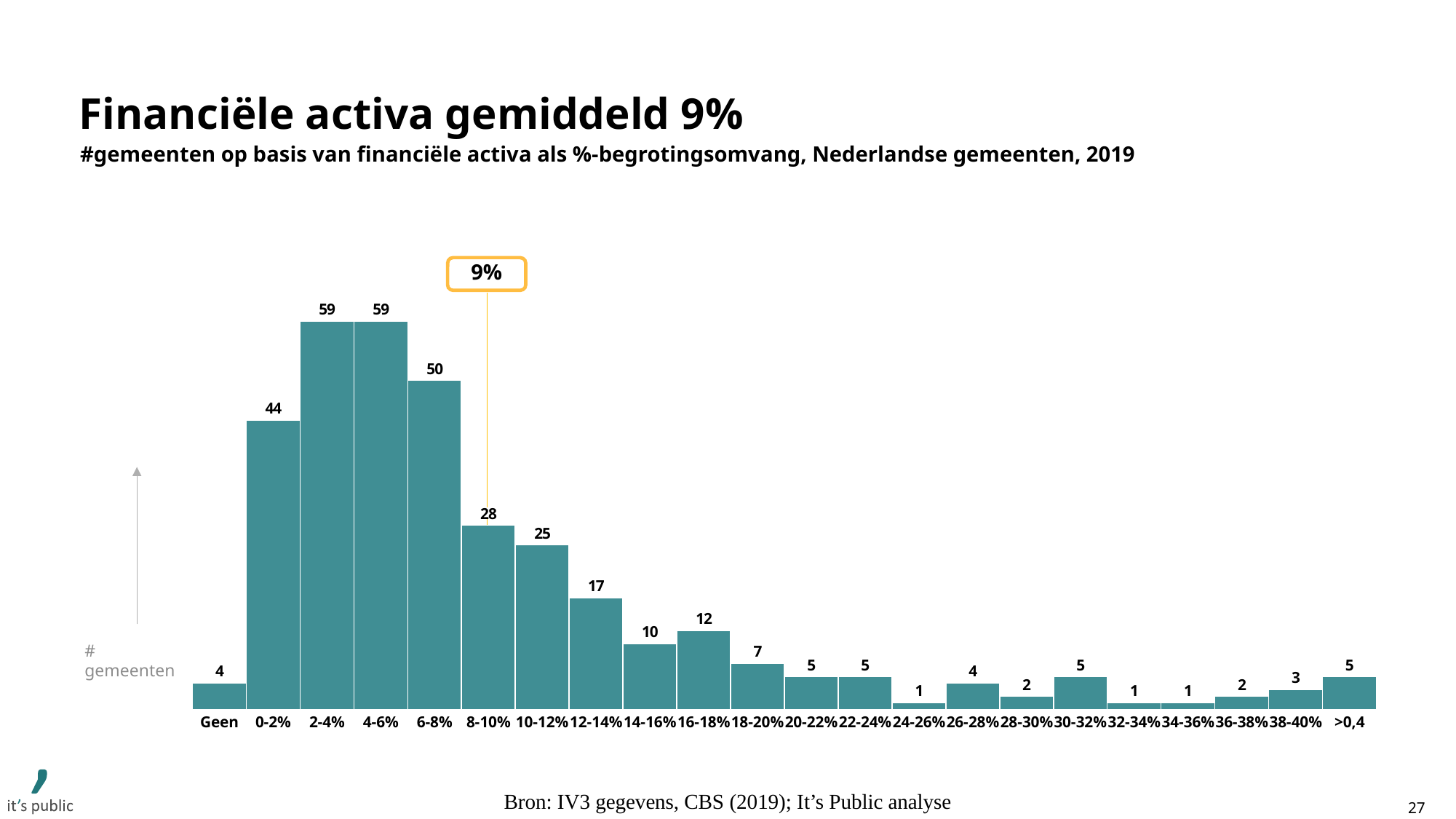
What is the value for the 6-8% category? 50 What kind of chart is shown on the slide? Bar chart What is the value for the 'Geen' category? 4 Which has a larger value, 14-16% or 16-18%? 16-18% What is the highest value shown on the chart? 59 What is the value for the 16-18% category? 12 What is the difference between the values for 8-10% and 10-12%? 3 How many municipalities fall in the 0-2% category? 44 What percentage is shown in the highlighted annotation box above the chart? 9% How many categories are shown on the x axis? 22 What is the value for the '>0,4' category? 5 What is the difference between the values for 6-8% and 12-14%? 33